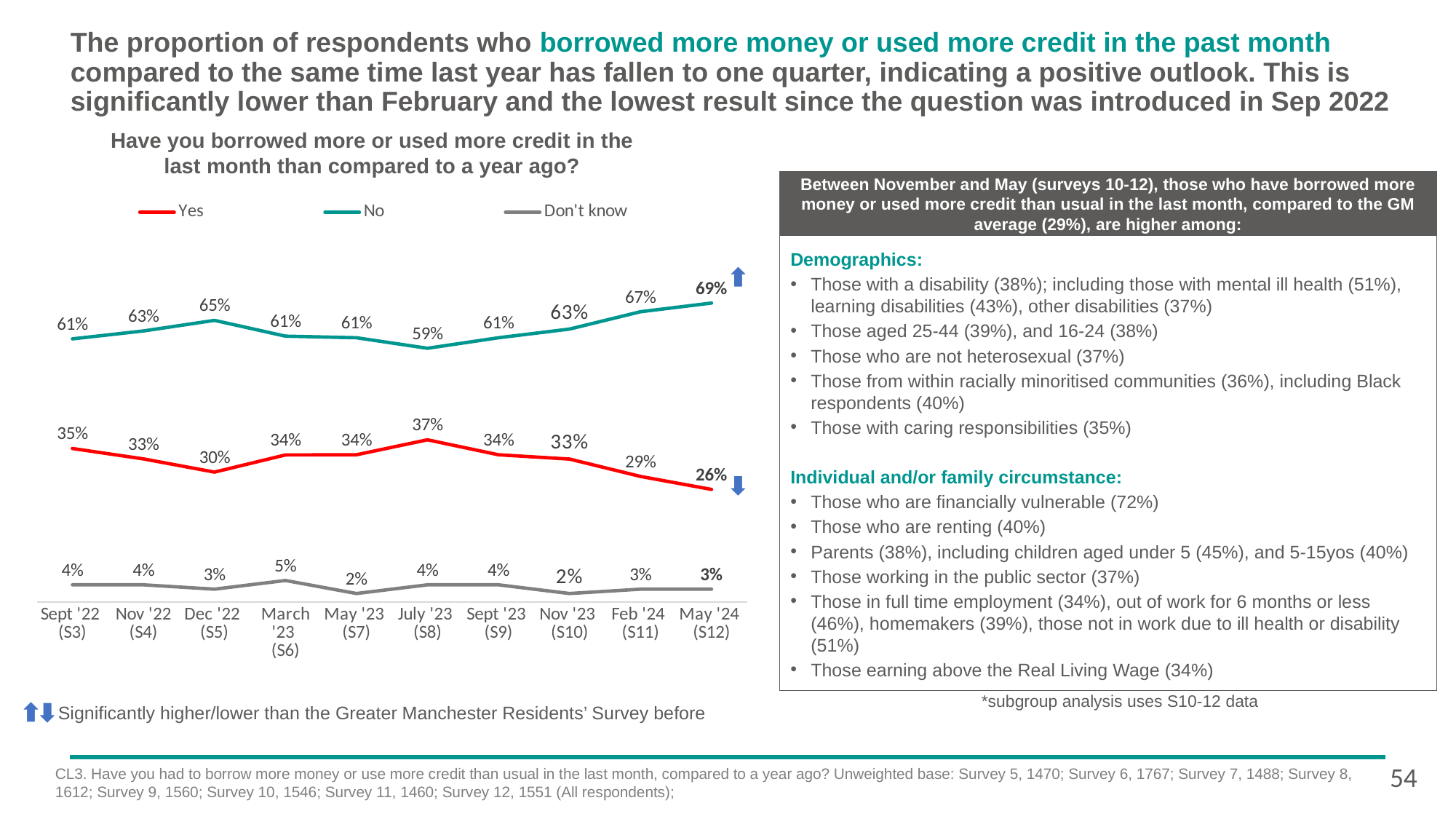
Does the 'No' series rise or fall between Nov '23 (S10) and May '24 (S12)? Rise Which is larger: the 'Yes' value in Sept '22 (S3) or the 'Yes' value in Feb '24 (S11)? Sept '22 (S3) How many survey points are plotted along the x axis? 10 In which survey period is the 'No' series at its lowest? July '23 (S8) What is the difference between the 'No' value and the 'Yes' value in May '24 (S12)? 43 percentage points What is the title of the chart? Have you borrowed more or used more credit in the last month than compared to a year ago? What is the value for 'Don't know' in March '23 (S6)? 5% How many series does the chart legend list? 3 What is the value for 'No' in July '23 (S8)? 59% In which survey period is the 'Yes' series at its highest? July '23 (S8) What is the value for 'Yes' in May '24 (S12)? 26% What type of chart is shown on the slide? Line chart